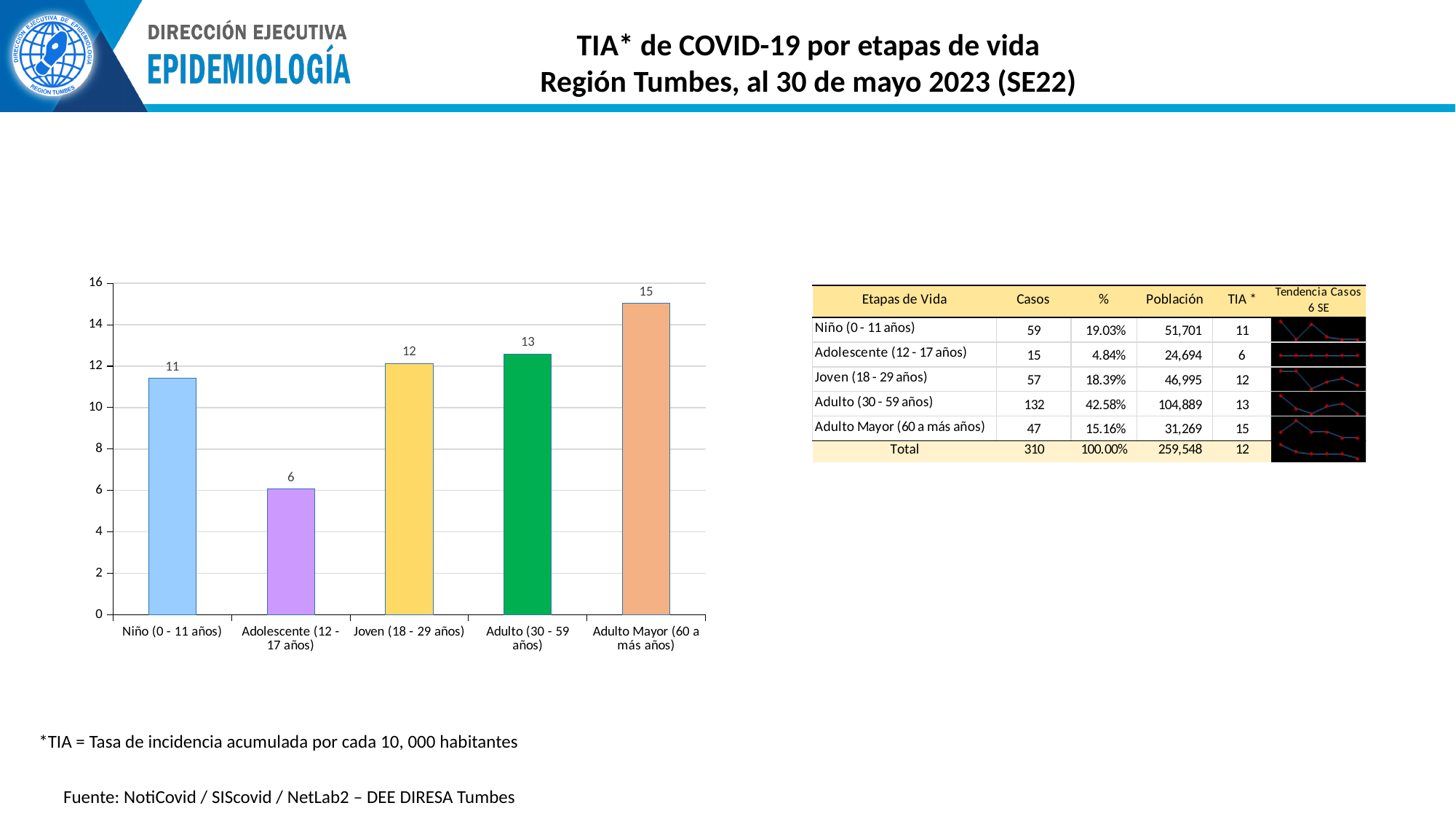
Is the bar for Adolescente (12 - 17 años) greater or less than 8? less What is the TIA value shown for Adolescente (12 - 17 años) in the bar chart? 6 What is the TIA value shown for Adulto Mayor (60 a más años) in the bar chart? 15 Which has a higher TIA in the bar chart, Niño (0 - 11 años) or Adulto (30 - 59 años)? Adulto (30 - 59 años) What is the TIA value shown for Niño (0 - 11 años) in the bar chart? 11 What is the TIA value shown for Joven (18 - 29 años) in the bar chart? 12 What is the difference between the TIA labels for Adulto Mayor (60 a más años) and Adolescente (12 - 17 años)? 9 How many life-stage categories are plotted in the bar chart? 5 What is the TIA value shown for Adulto (30 - 59 años) in the bar chart? 13 Which life stage has the lowest TIA in the bar chart? Adolescente (12 - 17 años) What type of chart is used to show TIA by life stage? Bar chart Which life stage has the highest TIA in the bar chart? Adulto Mayor (60 a más años)